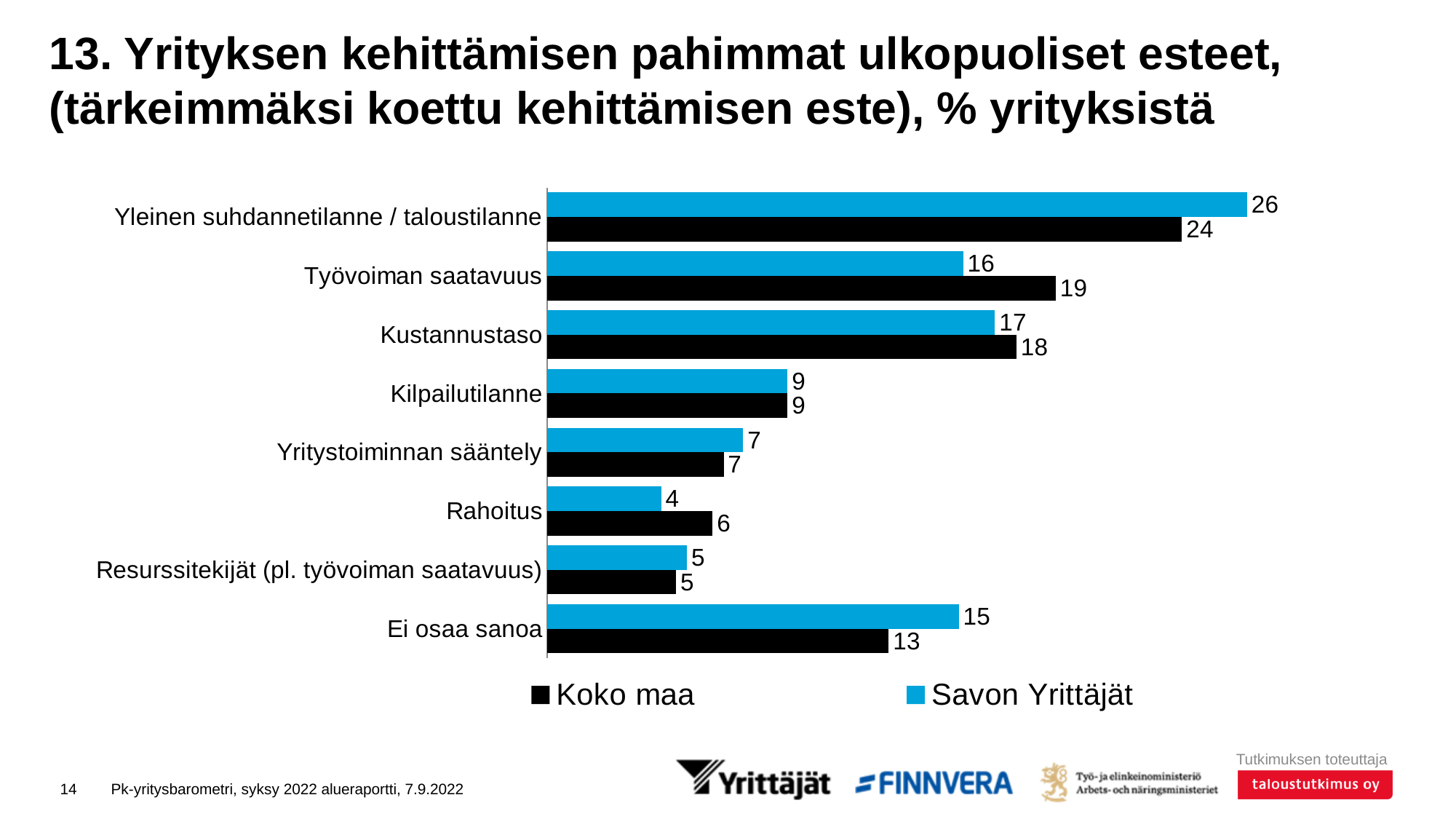
Which category has the lowest value for Savon Yrittäjät? Rahoitus For Kustannustaso, which series has the larger value, Koko maa or Savon Yrittäjät? Koko maa What kind of chart is shown on the slide? Bar chart What is the value for Savon Yrittäjät for Ei osaa sanoa? 15 What is the value for Savon Yrittäjät for Yleinen suhdannetilanne / taloustilanne? 26 What is the value for Koko maa for Rahoitus? 6 Which colour represents Savon Yrittäjät in the chart? Blue What is the difference between the Koko maa and Savon Yrittäjät values for Työvoiman saatavuus? 3 How many categories are shown on the chart? 8 How many series does the legend list? 2 Which category has the highest value for Savon Yrittäjät? Yleinen suhdannetilanne / taloustilanne What is the value for Koko maa for Työvoiman saatavuus? 19